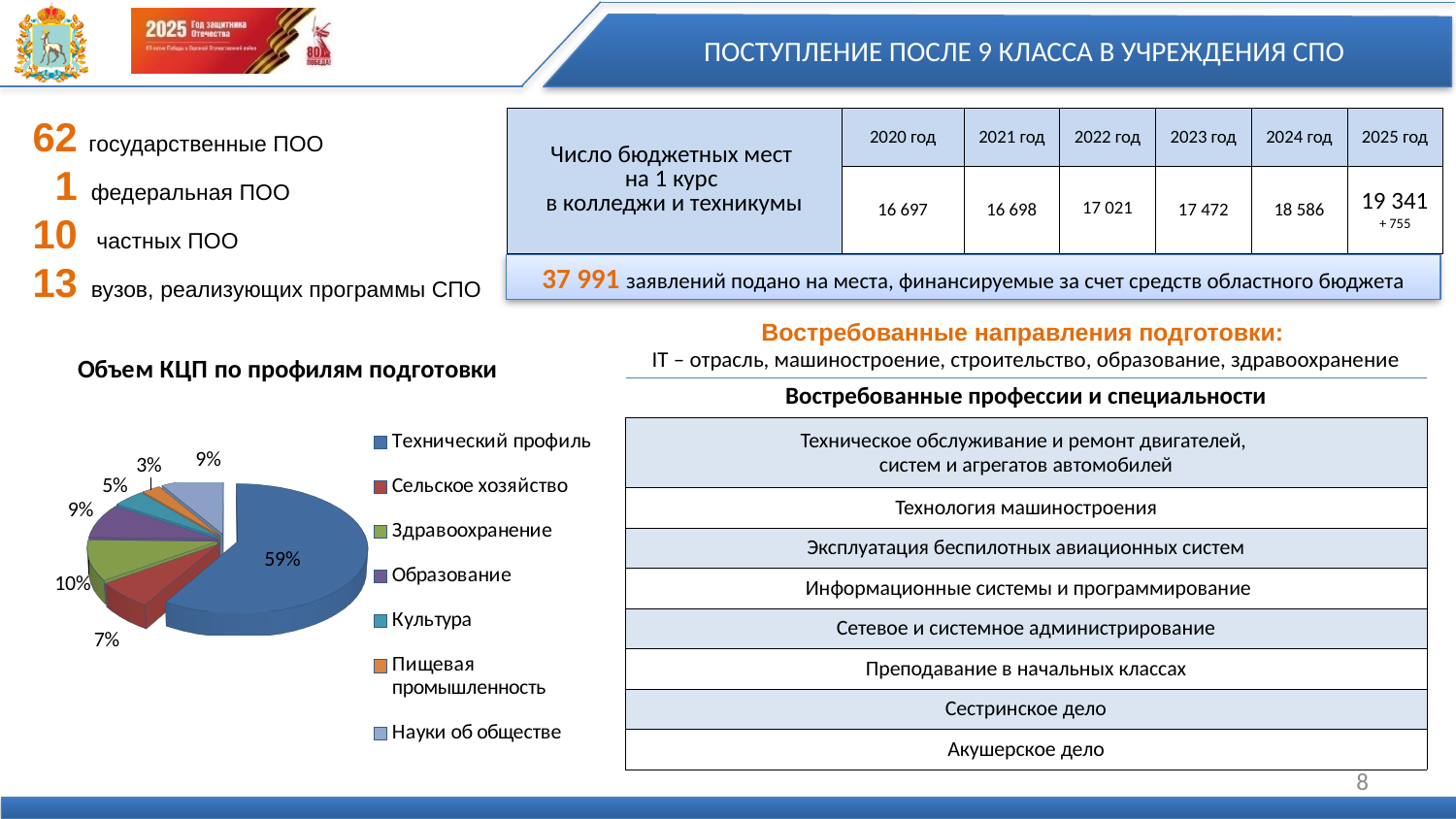
In the pie chart "Объем КЦП по профилям подготовки", which has the larger share: "Сельское хозяйство" or "Культура"? Сельское хозяйство In the pie chart "Объем КЦП по профилям подготовки", what colour is the "Технический профиль" slice? blue In the pie chart "Объем КЦП по профилям подготовки", what share does "Сельское хозяйство" have? 7% In the pie chart "Объем КЦП по профилям подготовки", what share does "Здравоохранение" have? 10% In the pie chart "Объем КЦП по профилям подготовки", how many percentage points larger is "Технический профиль" than "Здравоохранение"? 49 How many categories does the pie chart "Объем КЦП по профилям подготовки" show? 7 What kind of chart is shown under the heading "Объем КЦП по профилям подготовки"? pie chart How many entries does the legend of the pie chart "Объем КЦП по профилям подготовки" list? 7 In the pie chart "Объем КЦП по профилям подготовки", what share does "Технический профиль" have? 59% In the pie chart "Объем КЦП по профилям подготовки", which category has the largest share? Технический профиль In the pie chart "Объем КЦП по профилям подготовки", what share does "Культура" have? 5% In the pie chart "Объем КЦП по профилям подготовки", which category has the smallest share? Пищевая промышленность